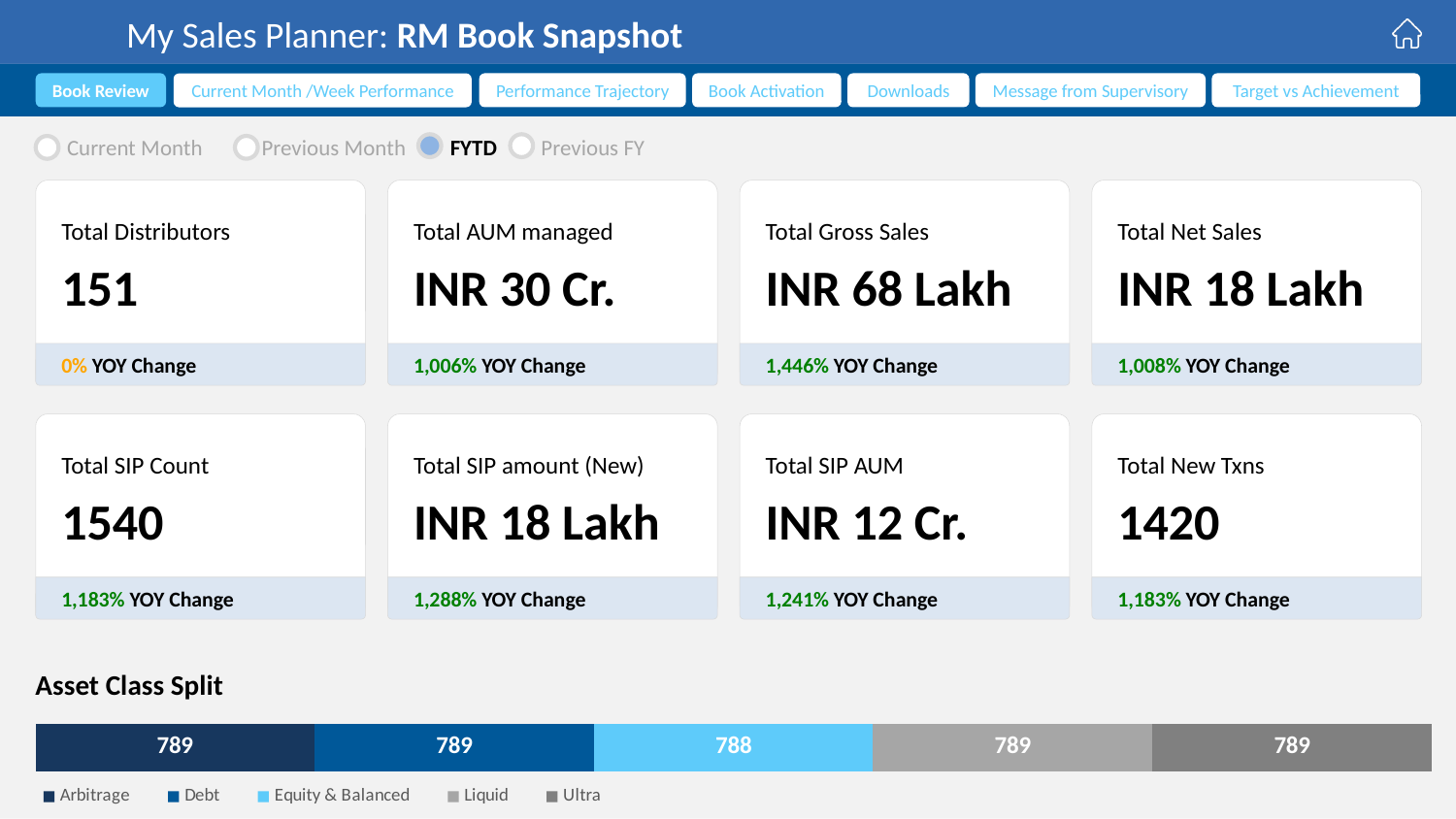
In the Asset Class Split chart, what is the value for Debt? 789 How many series does the legend of the Asset Class Split chart list? 5 In the Asset Class Split chart, what is the difference between the Debt value and the Equity & Balanced value? 1 In the Asset Class Split chart, what is the value for Liquid? 789 What kind of chart is the Asset Class Split chart? Stacked bar chart What is the title of the chart at the bottom of the slide? Asset Class Split In the Asset Class Split chart, which asset class has the lowest value? Equity & Balanced In the Asset Class Split chart, what is the value for Equity & Balanced? 788 In the Asset Class Split chart, what is the value for Arbitrage? 789 In the Asset Class Split chart, which is larger, the value for Arbitrage or the value for Equity & Balanced? Arbitrage In the Asset Class Split chart, what is the value for Ultra? 789 What is the total of all segments in the Asset Class Split stacked bar? 3944